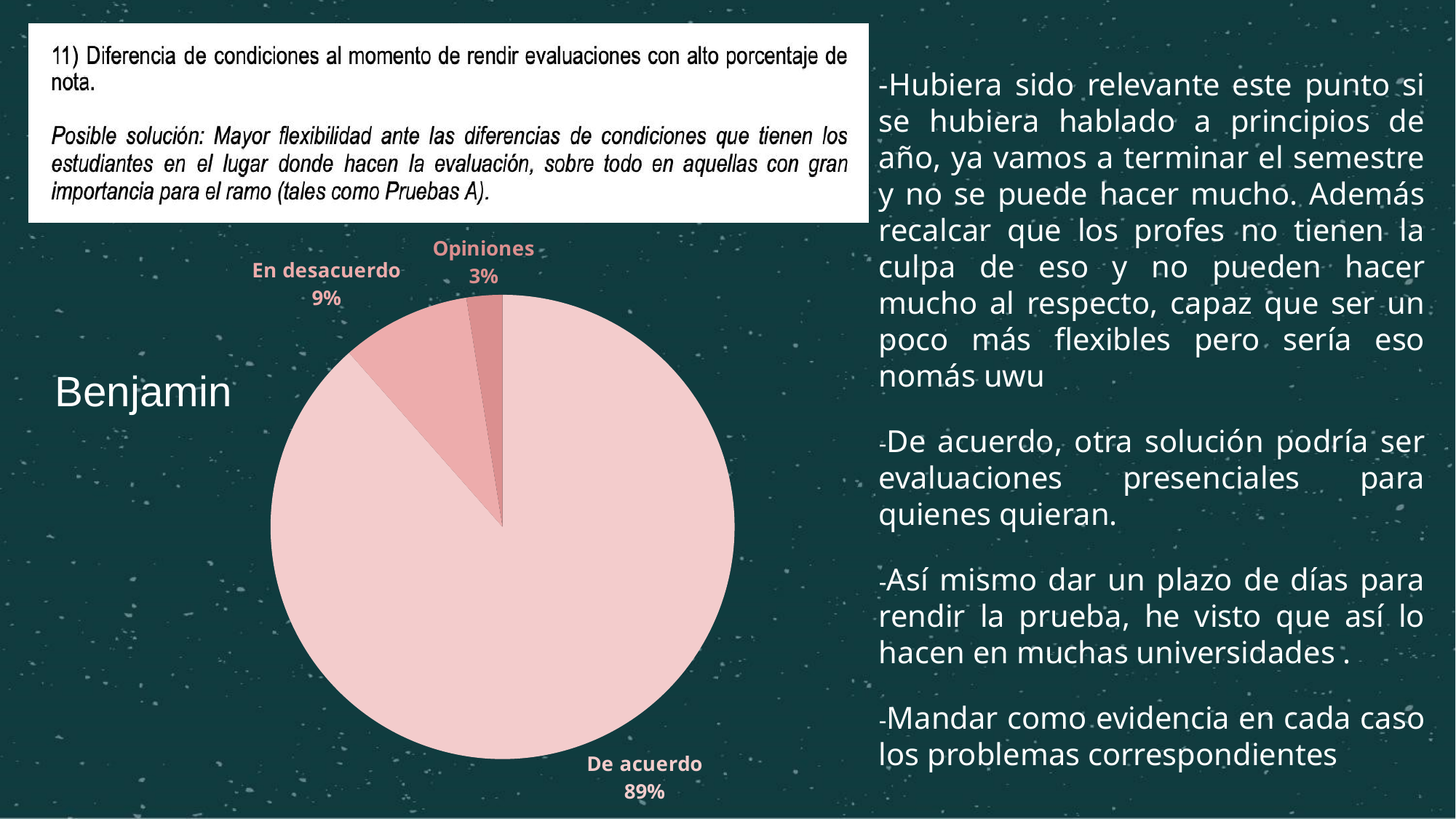
What share of the pie does "Opiniones" represent? 3% Which is larger, the "En desacuerdo" slice or the "Opiniones" slice? En desacuerdo What share of the pie does "De acuerdo" represent? 89% Which slice of the pie is the largest? De acuerdo Which slice of the pie is the smallest? Opiniones What kind of chart is shown on the slide? pie chart What name appears to the left of the pie chart? Benjamin Which slice of the pie is drawn in the darkest shade of pink? Opiniones What is the difference in percentage points between "De acuerdo" and "En desacuerdo"? 80 What is the difference in percentage points between "En desacuerdo" and "Opiniones"? 6 What share of the pie does "En desacuerdo" represent? 9% How many slices does the pie chart have? 3